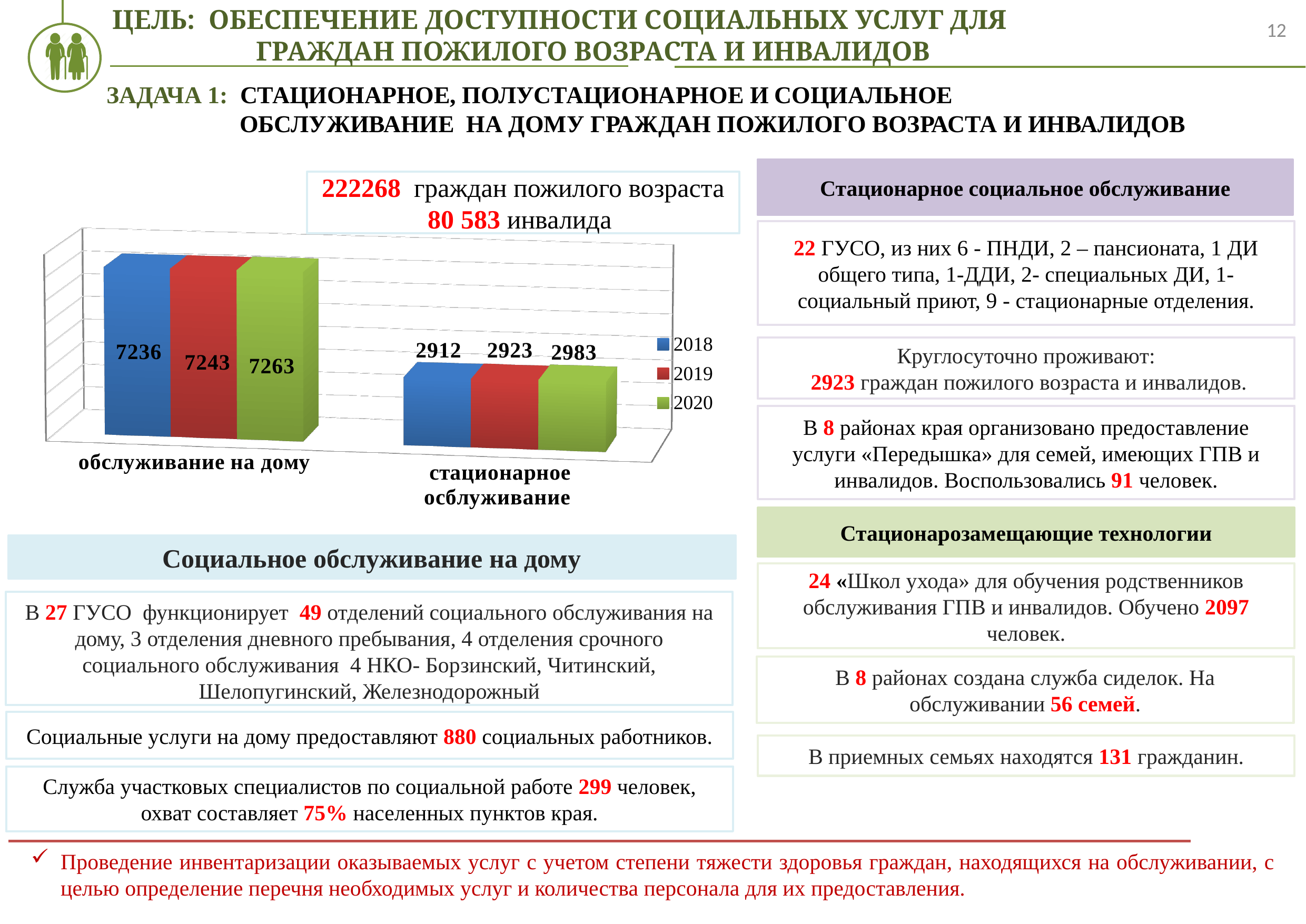
What is the value for 2018 in the category "обслуживание на дому"? 7236 Which year has the lowest value in the category "обслуживание на дому"? 2018 What type of chart is shown on the slide? bar chart Which year has the highest value in the category "стационарное обслуживание"? 2020 Which category has the larger value for 2019: "обслуживание на дому" or "стационарное обслуживание"? обслуживание на дому What is the difference between the 2020 and 2018 values in the category "стационарное обслуживание"? 71 What is the value for 2019 in the category "стационарное обслуживание"? 2923 How many categories are shown on the x axis of the chart? 2 How many series does the chart legend list? 3 Which colour represents the 2019 series in the chart? red What is the value for 2020 in the category "стационарное обслуживание"? 2983 What is the value for 2020 in the category "обслуживание на дому"? 7263